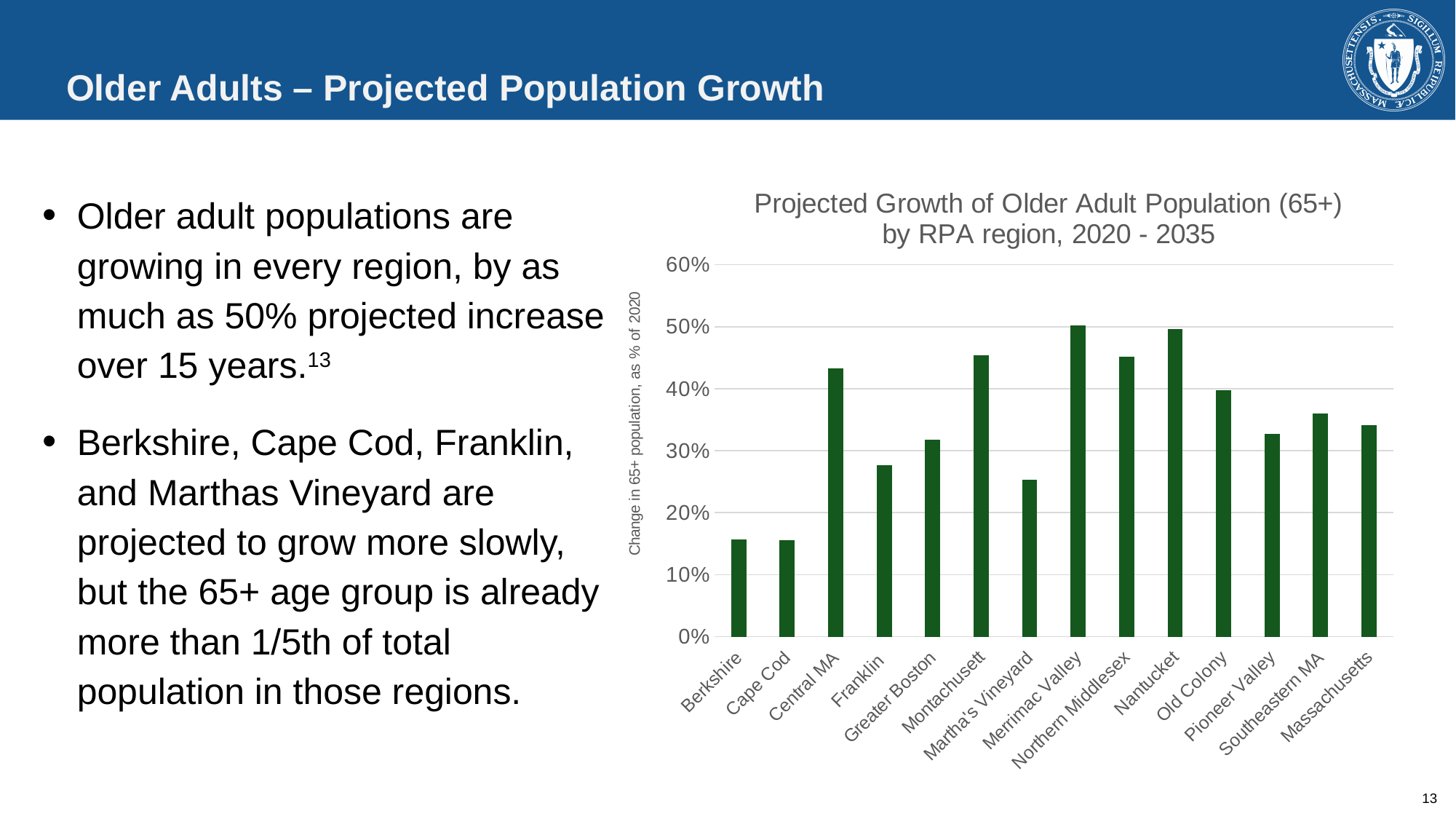
How many regions are plotted on the x axis of the chart? 14 Is the value for Franklin greater or less than 30%? less What is the label on the y axis of the chart? Change in 65+ population, as % of 2020 Is the value for Southeastern MA greater or less than 40%? less Which has the larger projected growth, Montachusett or Greater Boston? Montachusett Is the value for Central MA greater or less than 40%? greater What is the title of the chart? Projected Growth of Older Adult Population (65+) by RPA region, 2020 - 2035 Which has the larger projected growth, Central MA or Franklin? Central MA What kind of chart is shown on the slide? bar chart